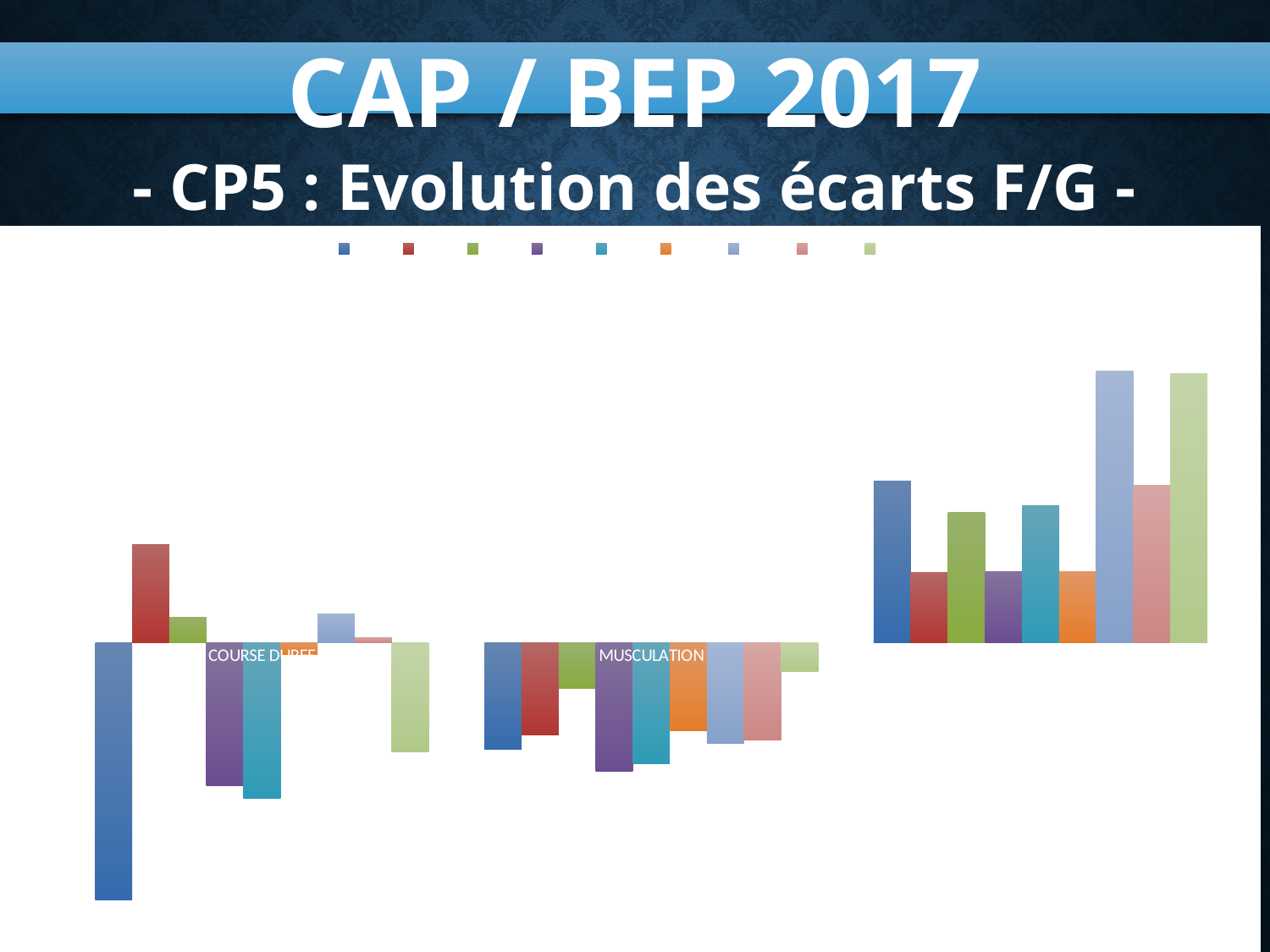
What kind of chart is shown on the slide? bar chart In the MUSCULATION group, is the dark blue bar above or below the baseline? below In the MUSCULATION group, how many bars are above the baseline? 0 What is the subtitle of the slide shown above the chart? - CP5 : Evolution des écarts F/G - How many series does the legend list? 9 How many groups of bars are plotted in the chart? 3 In the COURSE DUREE group, is the red bar or the green bar taller above the baseline? red Which labelled category contains the bar that extends furthest below the baseline? COURSE DUREE How many bars are plotted in the MUSCULATION group? 9